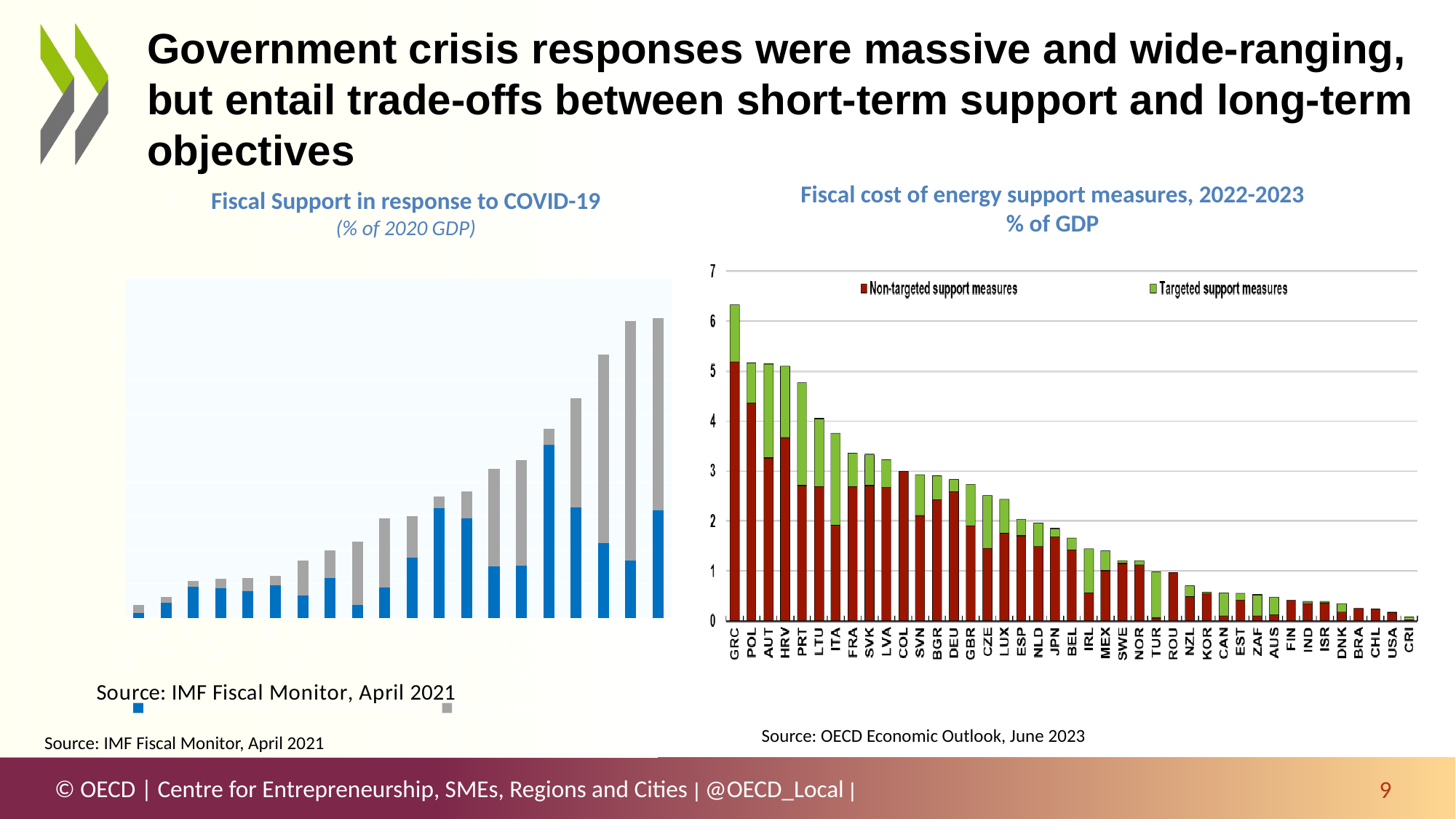
What kind of chart is the 'Fiscal Support in response to COVID-19' chart on the left? Stacked bar chart In the 'Fiscal cost of energy support measures, 2022-2023' chart, which country has the highest total fiscal cost? GRC In the 'Fiscal cost of energy support measures, 2022-2023' chart, how many series does the legend list? 2 In the 'Fiscal cost of energy support measures, 2022-2023' chart, which country has the lowest total fiscal cost? CRI In the 'Fiscal cost of energy support measures, 2022-2023' chart, is the total value for GRC greater or less than 6? greater In the 'Fiscal cost of energy support measures, 2022-2023' chart, which has a larger total fiscal cost, GRC or POL? GRC In the 'Fiscal cost of energy support measures, 2022-2023' chart, how many countries are shown on the x axis? 41 In the 'Fiscal cost of energy support measures, 2022-2023' chart, which colour represents non-targeted support measures? Red What kind of chart is the 'Fiscal cost of energy support measures, 2022-2023' chart on the right? Stacked bar chart In the 'Fiscal cost of energy support measures, 2022-2023' chart, is the total value for NZL greater or less than 1? less In the 'Fiscal cost of energy support measures, 2022-2023' chart, do the total values rise or fall moving from left to right along the x axis? Fall In the 'Fiscal cost of energy support measures, 2022-2023' chart, is the total value for PRT greater or less than 4? greater